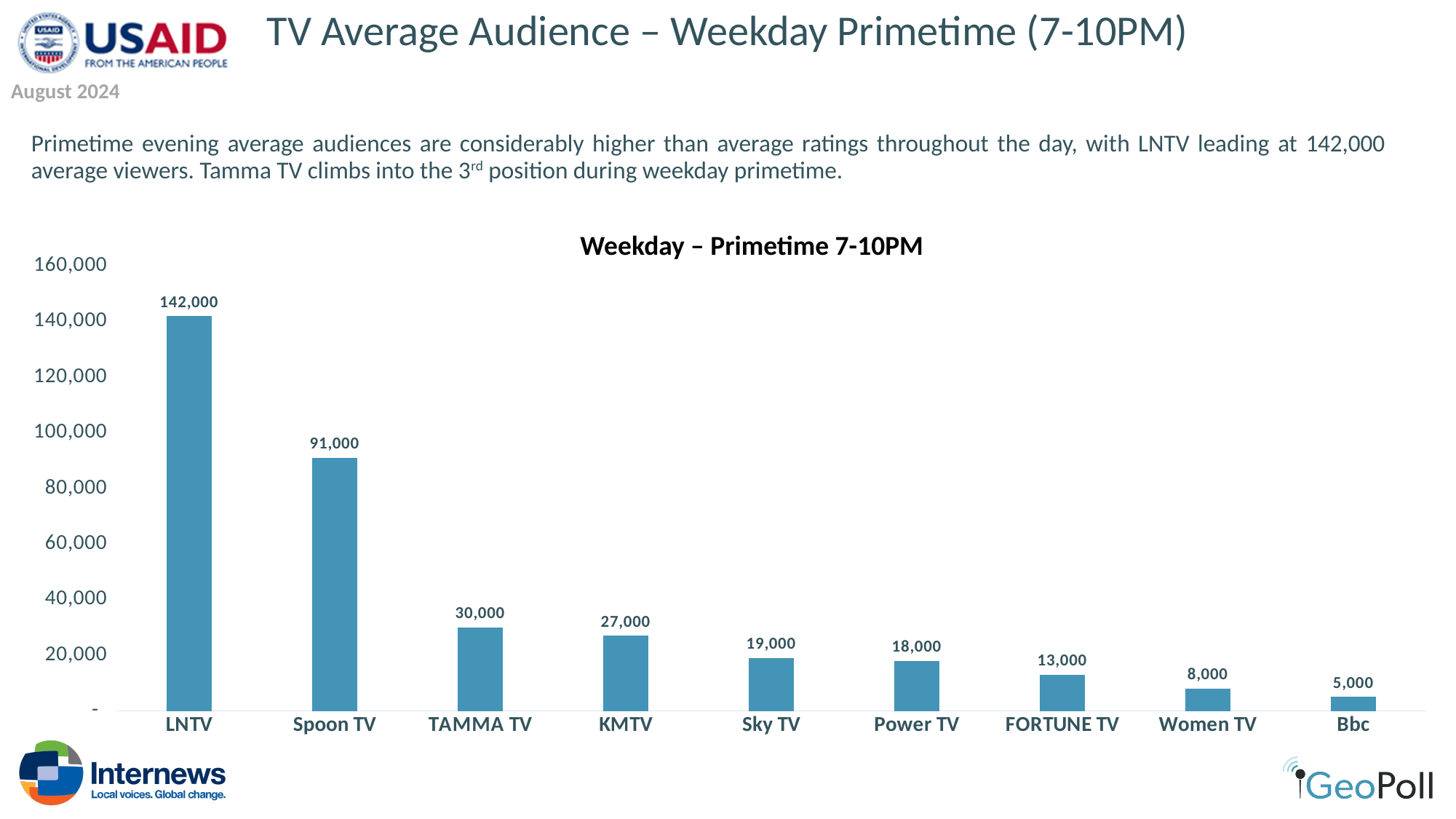
Which has a larger average audience, Sky TV or Power TV? Sky TV Which channel has the lowest average audience? Bbc What is the average audience for Women TV? 8,000 What kind of chart is shown on the slide? Bar chart What is the average audience for LNTV? 142,000 How many channels are shown in the chart? 9 What is the difference between the average audiences of LNTV and Spoon TV? 51,000 Which channel has the highest average audience? LNTV What is the average audience for KMTV? 27,000 What is the average audience for Spoon TV? 91,000 What is the title of the chart? Weekday – Primetime 7-10PM What is the difference between the average audiences of TAMMA TV and FORTUNE TV? 17,000